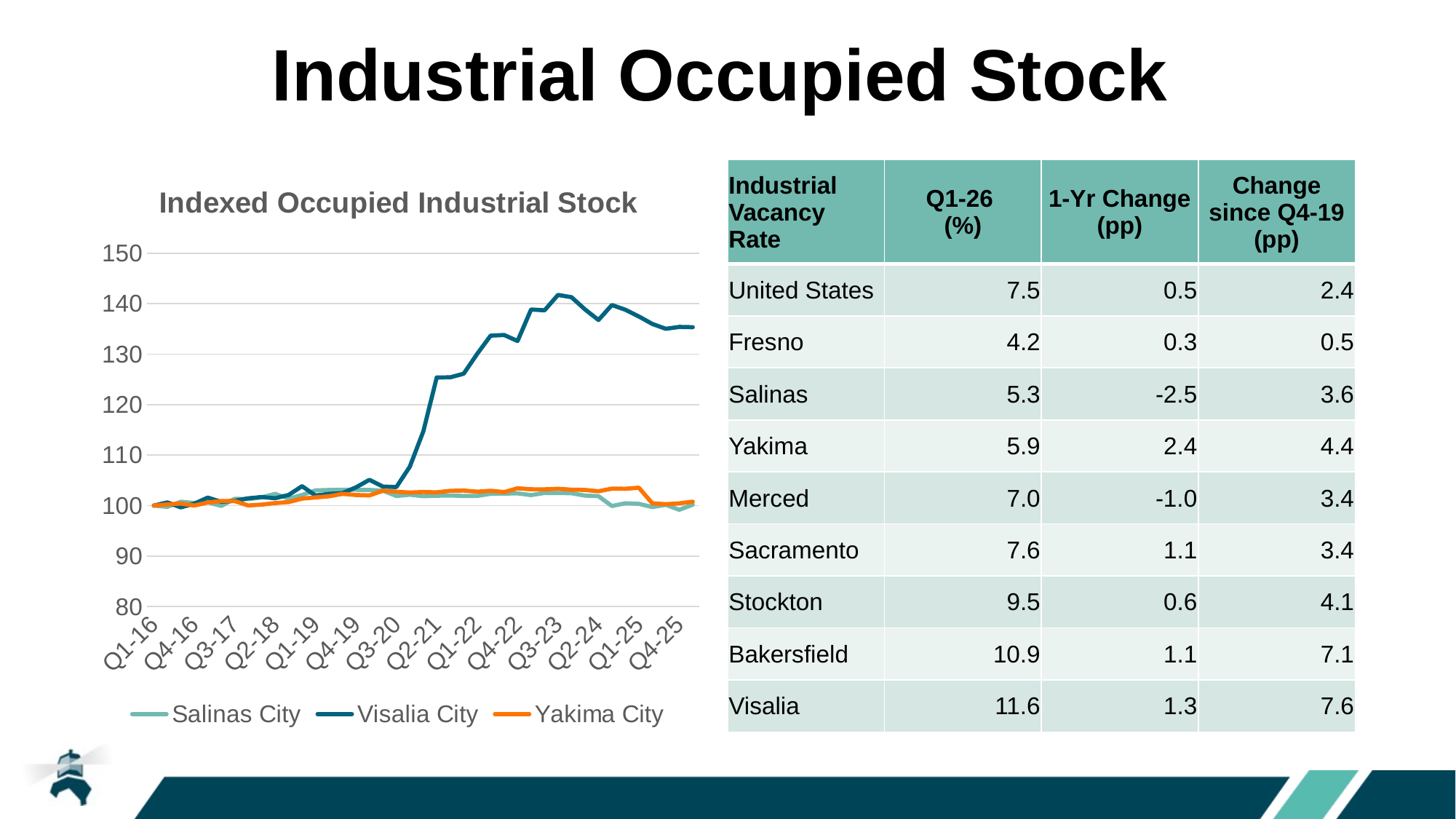
What is the title of the chart on the slide? Indexed Occupied Industrial Stock In the Indexed Occupied Industrial Stock chart, is the value for Visalia City at Q1-22 greater or less than 120? greater In the Indexed Occupied Industrial Stock chart, is the value for Visalia City at Q3-23 greater or less than 130? greater In the Indexed Occupied Industrial Stock chart, which is larger at Q3-23: Visalia City or Salinas City? Visalia City In the Indexed Occupied Industrial Stock chart, is the value for Salinas City at Q4-25 greater or less than 110? less In the Indexed Occupied Industrial Stock chart, does the Visalia City series rise or fall overall from Q1-16 to Q4-25? rise What kind of chart is the Indexed Occupied Industrial Stock chart? line chart Which series in the Indexed Occupied Industrial Stock chart is drawn in orange? Yakima City How many series does the legend of the Indexed Occupied Industrial Stock chart list? 3 In the Indexed Occupied Industrial Stock chart, which series has the highest value at Q4-25? Visalia City